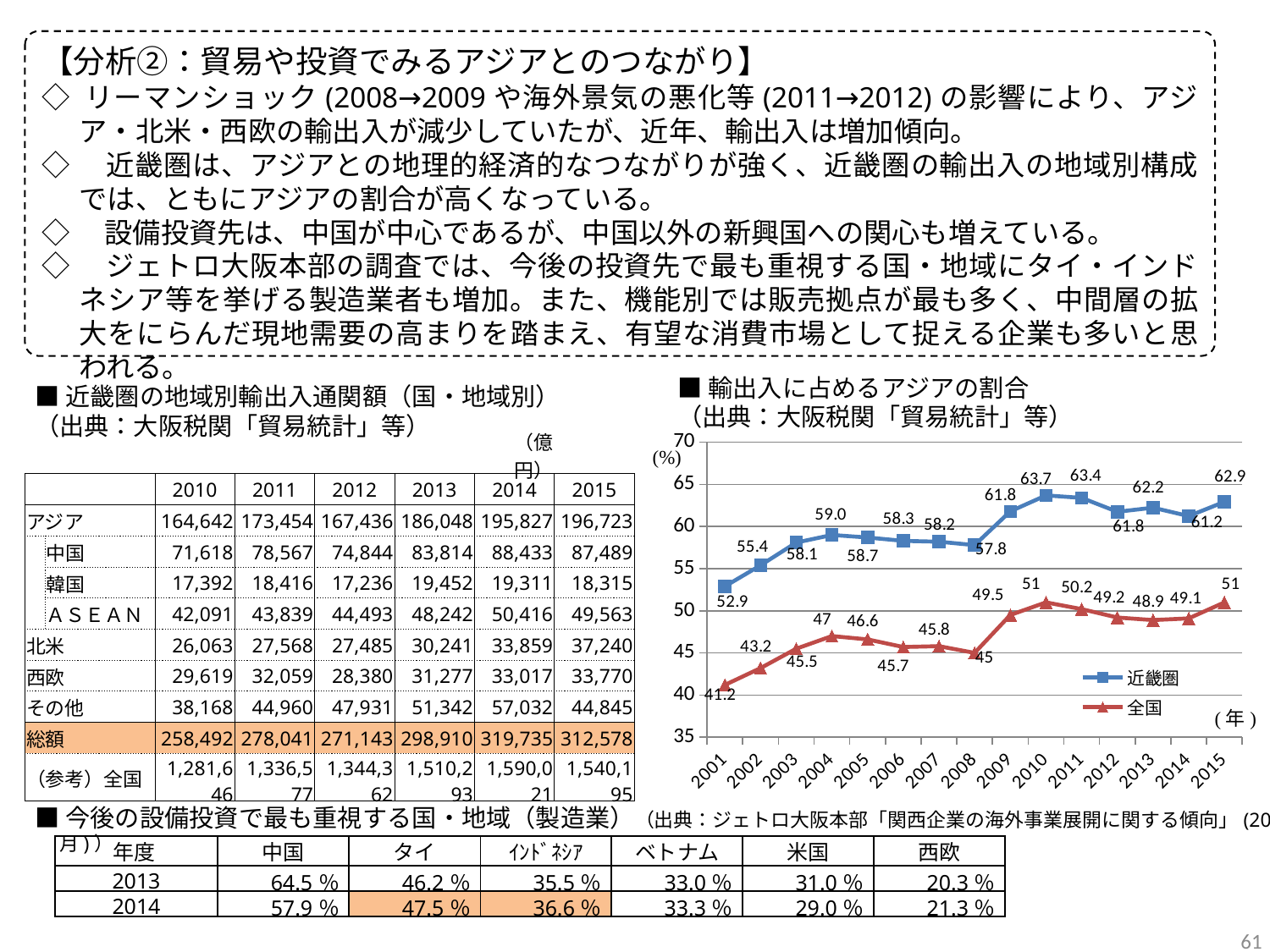
Which series has the larger value in 2008, 近畿圏 or 全国? 近畿圏 What is the difference between the 近畿圏 and 全国 values in 2015? 11.9 In which year is the 全国 series at its lowest value? 2001 Does the 近畿圏 series rise or fall from 2001 to 2004? rise What are the two series named in the chart legend? 近畿圏 and 全国 What type of chart is shown on the slide? line chart What is the value for 近畿圏 in 2010? 63.7 What is the value for 近畿圏 in 2015? 62.9 How many series does the legend of the chart list? 2 How many years are plotted along the x axis of the chart? 15 What is the value for 全国 in 2001? 41.2 In which year does the 近畿圏 series reach its highest value? 2010